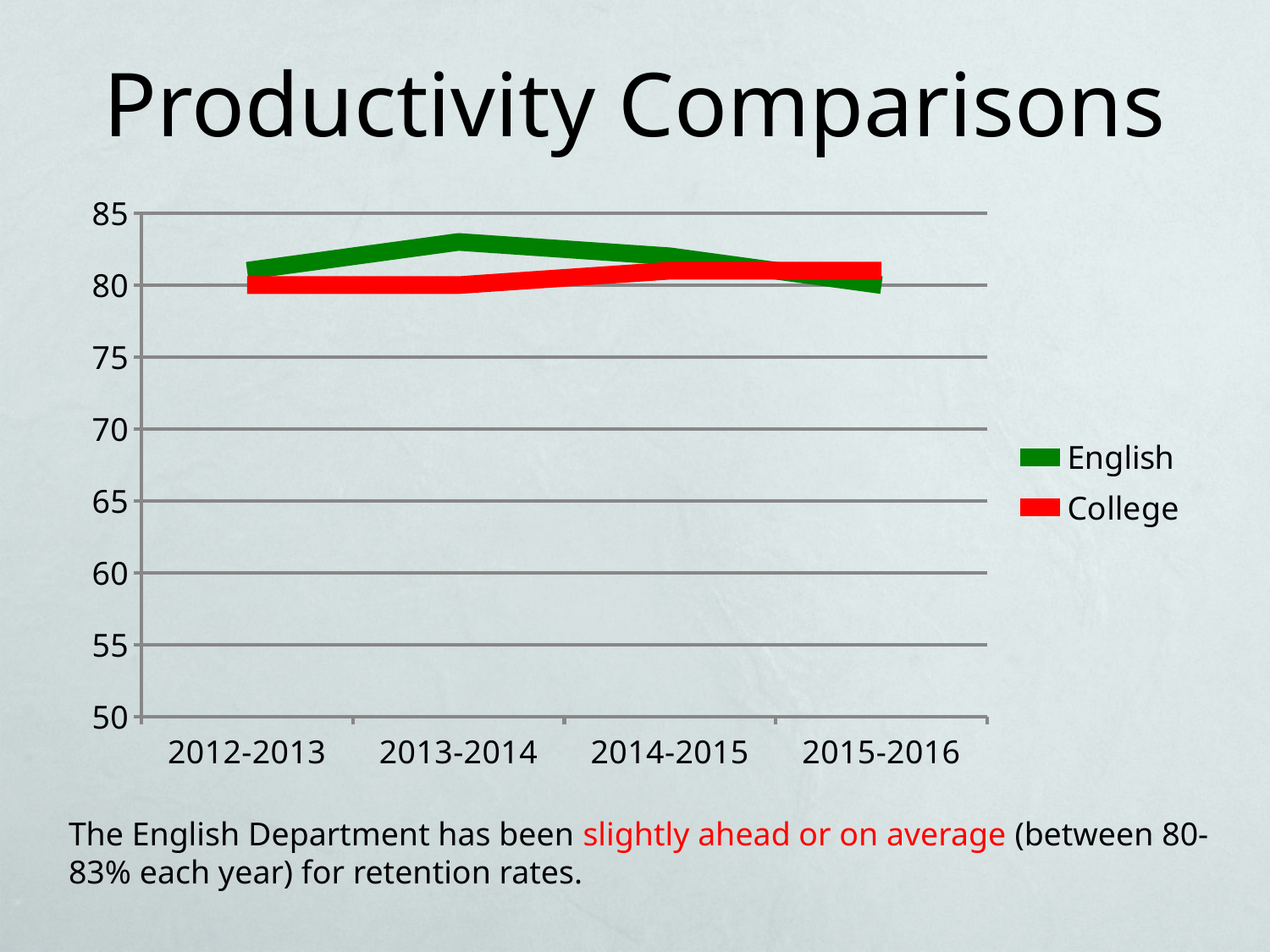
Is the value for College in 2012-2013 greater or less than 75? greater In 2013-2014, which series has the larger value, English or College? English Does the English series rise or fall from 2013-2014 to 2015-2016? fall Is the value for English in 2015-2016 greater or less than 85? less In which year does the English series reach its highest value? 2013-2014 What is the title of the chart? Productivity Comparisons Is the value for English in 2013-2014 greater or less than 80? greater How many series does the legend list? 2 Which colour represents the College series in the legend? red How many academic years are shown on the x axis? 4 What kind of chart is shown on the slide? line chart What is the lowest value shown on the y axis? 50